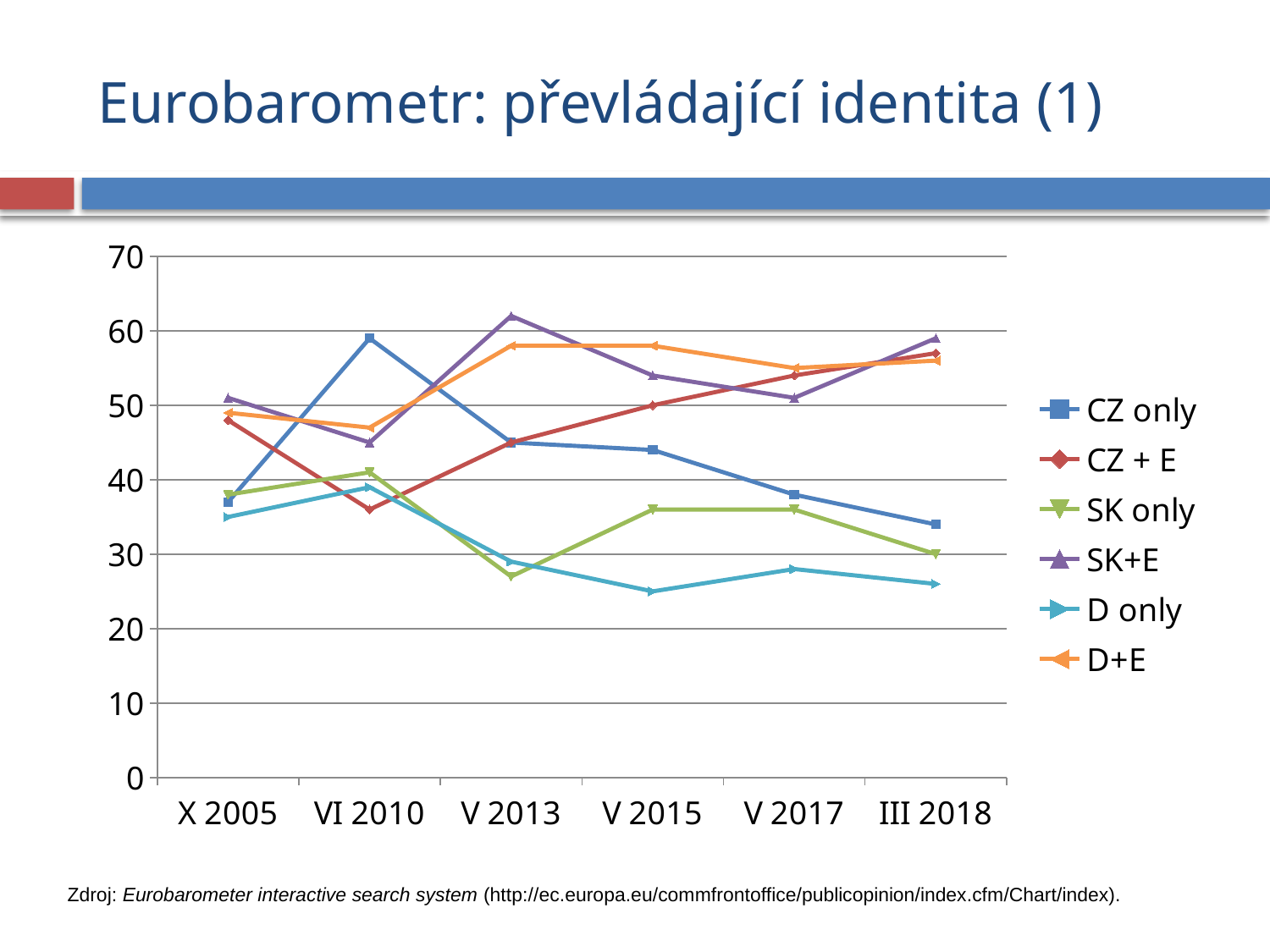
How many time points are shown on the x axis? 6 Is the value for CZ + E at III 2018 greater or less than 50? greater How many series does the legend list? 6 Is the value for SK+E at V 2013 greater or less than 50? greater Which series has the highest value at V 2013? SK+E Does the CZ only series rise or fall from VI 2010 to III 2018? fall Is the value for CZ only at VI 2010 greater or less than 50? greater Which series has the lowest value at V 2015? D only At X 2005, which is larger: CZ only or SK+E? SK+E What kind of chart is shown on the slide? line chart Which series has the highest value at VI 2010? CZ only